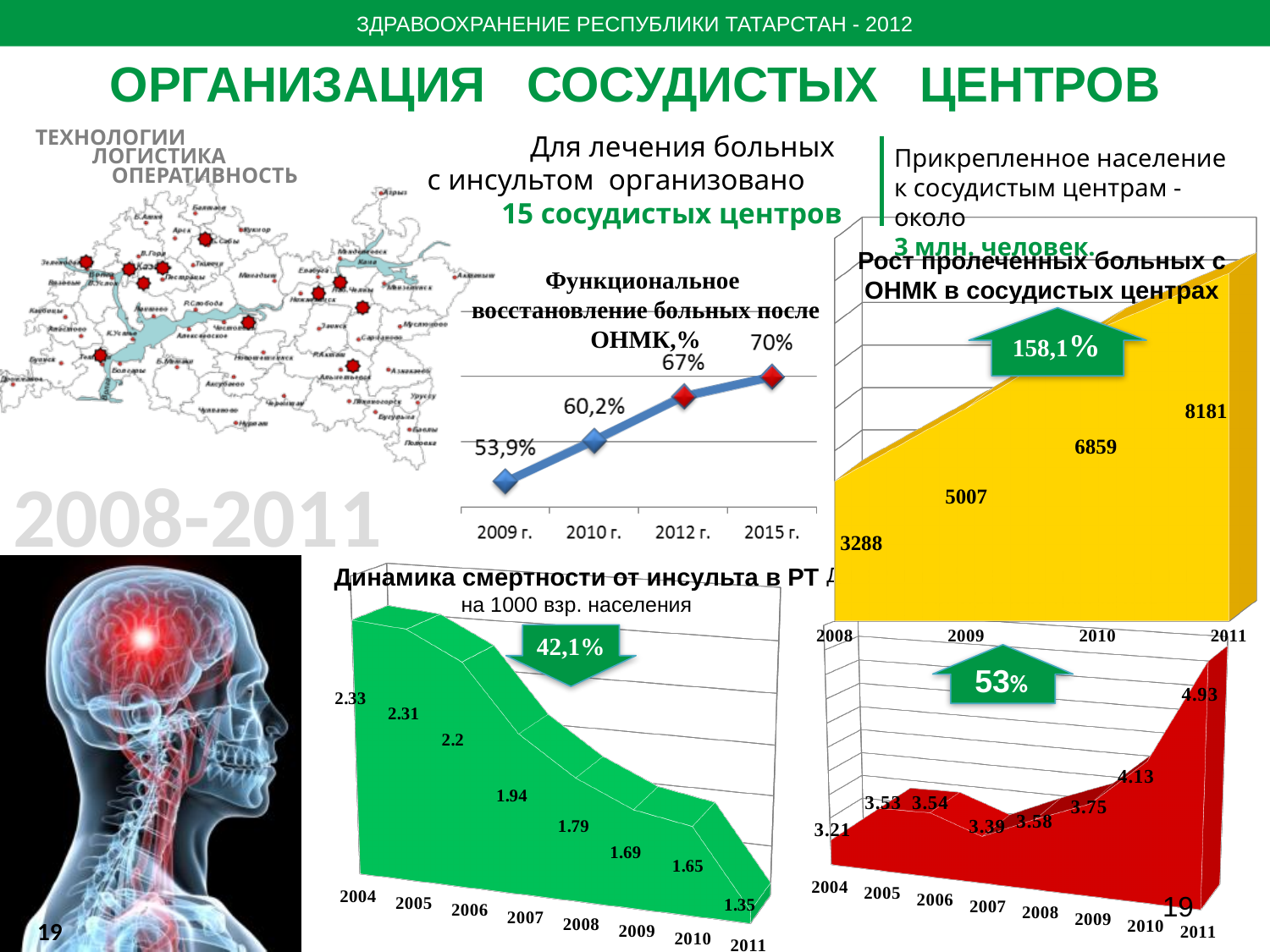
In the red area chart at the bottom right of the slide, what is the value for 2011? 4.93 In the chart 'Динамика смертности от инсульта в РТ', what percentage is shown on the arrow? 42,1% In the chart 'Функциональное восстановление больных после ОНМК,%', how many data points are plotted? 4 In the chart 'Рост пролеченных больных с ОНМК в сосудистых центрах', what is the difference between the 2010 and 2009 values? 1852 In the chart 'Функциональное восстановление больных после ОНМК,%', do the values rise or fall from 2009 г. to 2015 г.? rise In the chart 'Рост пролеченных больных с ОНМК в сосудистых центрах', what is the value for 2008? 3288 In the chart 'Функциональное восстановление больных после ОНМК,%', what is the value for 2015 г.? 70% In the red area chart at the bottom right of the slide, which is larger, the value for 2004 or the value for 2010? 2010 In the chart 'Функциональное восстановление больных после ОНМК,%', what is the value for 2009 г.? 53,9% In the chart 'Рост пролеченных больных с ОНМК в сосудистых центрах', what is the value for 2011? 8181 In the chart 'Динамика смертности от инсульта в РТ', which year has the lowest value? 2011 In the chart 'Динамика смертности от инсульта в РТ', what is the value for 2007? 1.94